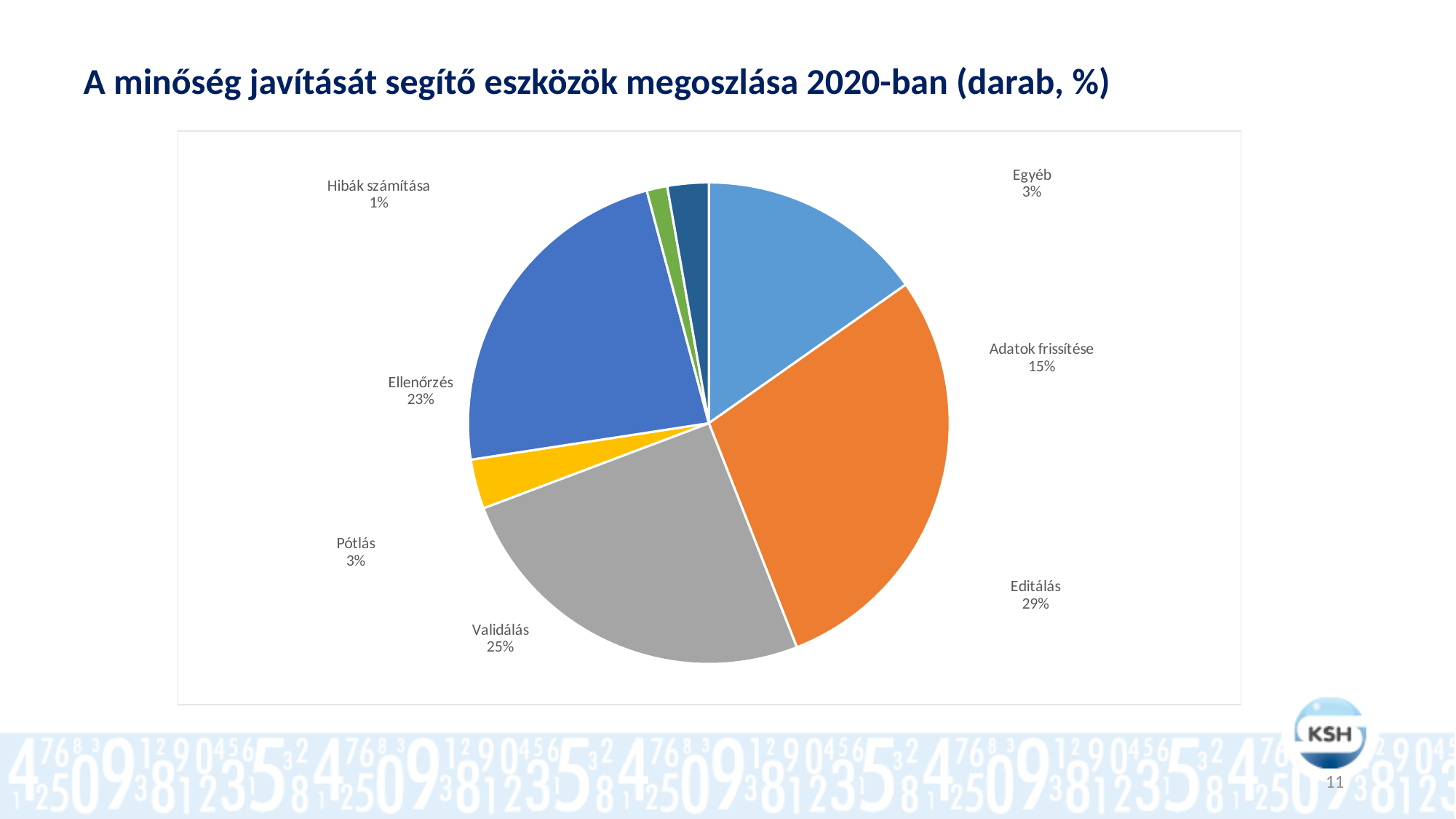
Which is larger, the share for Ellenőrzés or the share for Adatok frissítése? Ellenőrzés What is the value shown for Hibák számítása? 1% What is the title of the slide? A minőség javítását segítő eszközök megoszlása 2020-ban (darab, %) Which category has the smallest share of the pie? Hibák számítása What share of the pie does Validálás have? 25% Which category has the largest share of the pie? Editálás How many slices does the pie chart have? 7 What is the value shown for Ellenőrzés? 23% What is the value shown for Adatok frissítése? 15% What share of the pie does Editálás have? 29% What is the difference in percentage points between Editálás and Validálás? 4 What kind of chart is shown on the slide? pie chart